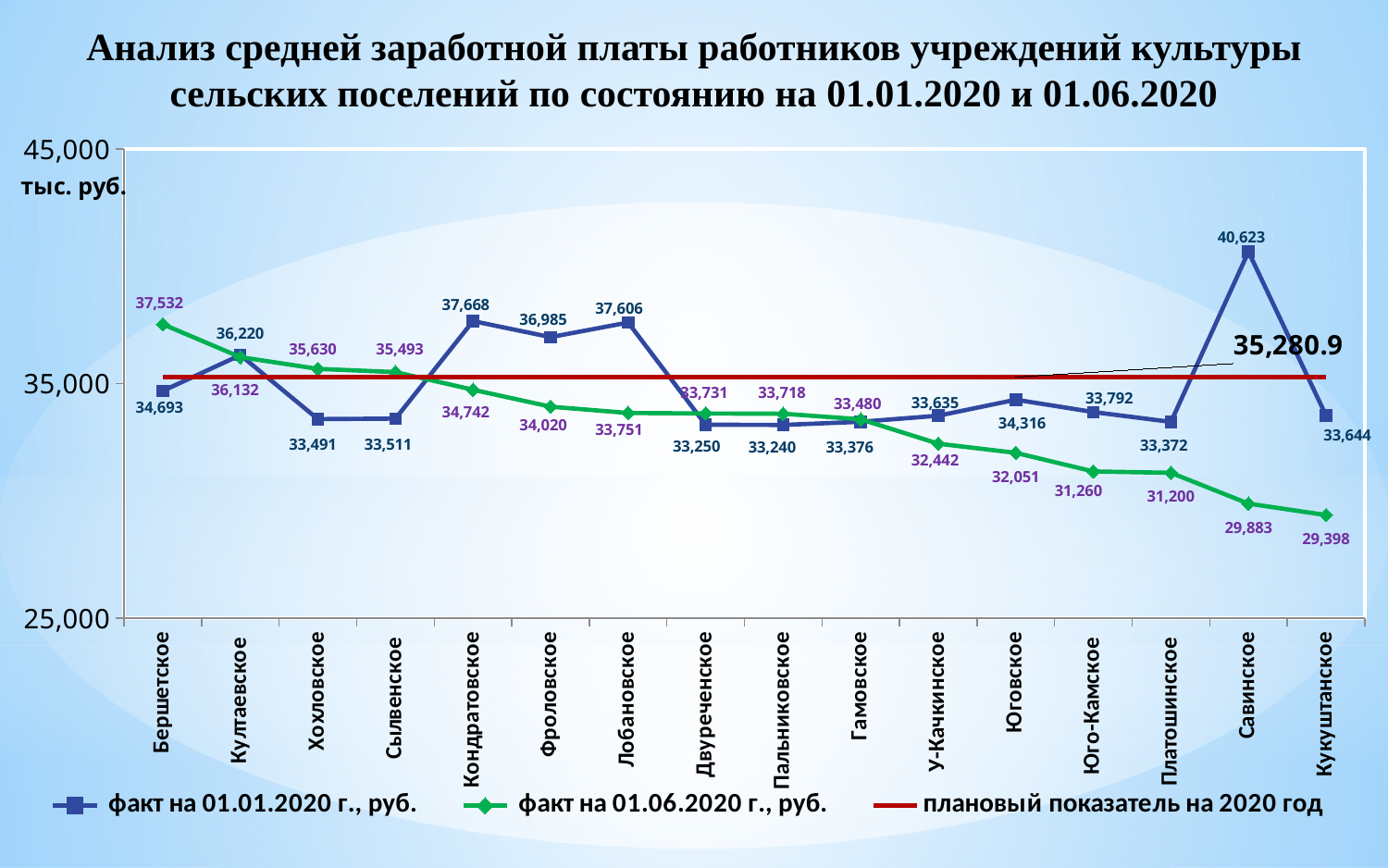
What is the value for Савинское in the series 'факт на 01.01.2020 г., руб.'? 40,623 What is the difference between the 01.01.2020 and 01.06.2020 values for Савинское? 10,740 Which category has the highest value in the series 'факт на 01.01.2020 г., руб.'? Савинское How many categories (settlements) are shown on the x axis? 16 What is the value of the 'плановый показатель на 2020 год' line? 35,280.9 What is the value for Кукуштанское in the series 'факт на 01.06.2020 г., руб.'? 29,398 Which category has the lowest value in the series 'факт на 01.06.2020 г., руб.'? Кукуштанское What kind of chart is shown on the slide? Line chart Does the series 'факт на 01.06.2020 г., руб.' generally rise or fall from left to right along the x axis? Fall How many series does the legend list? 3 For Бершетское, which is larger: the value for 01.01.2020 or the value for 01.06.2020? 01.06.2020 (37,532) Which category has the highest value in the series 'факт на 01.06.2020 г., руб.'? Бершетское